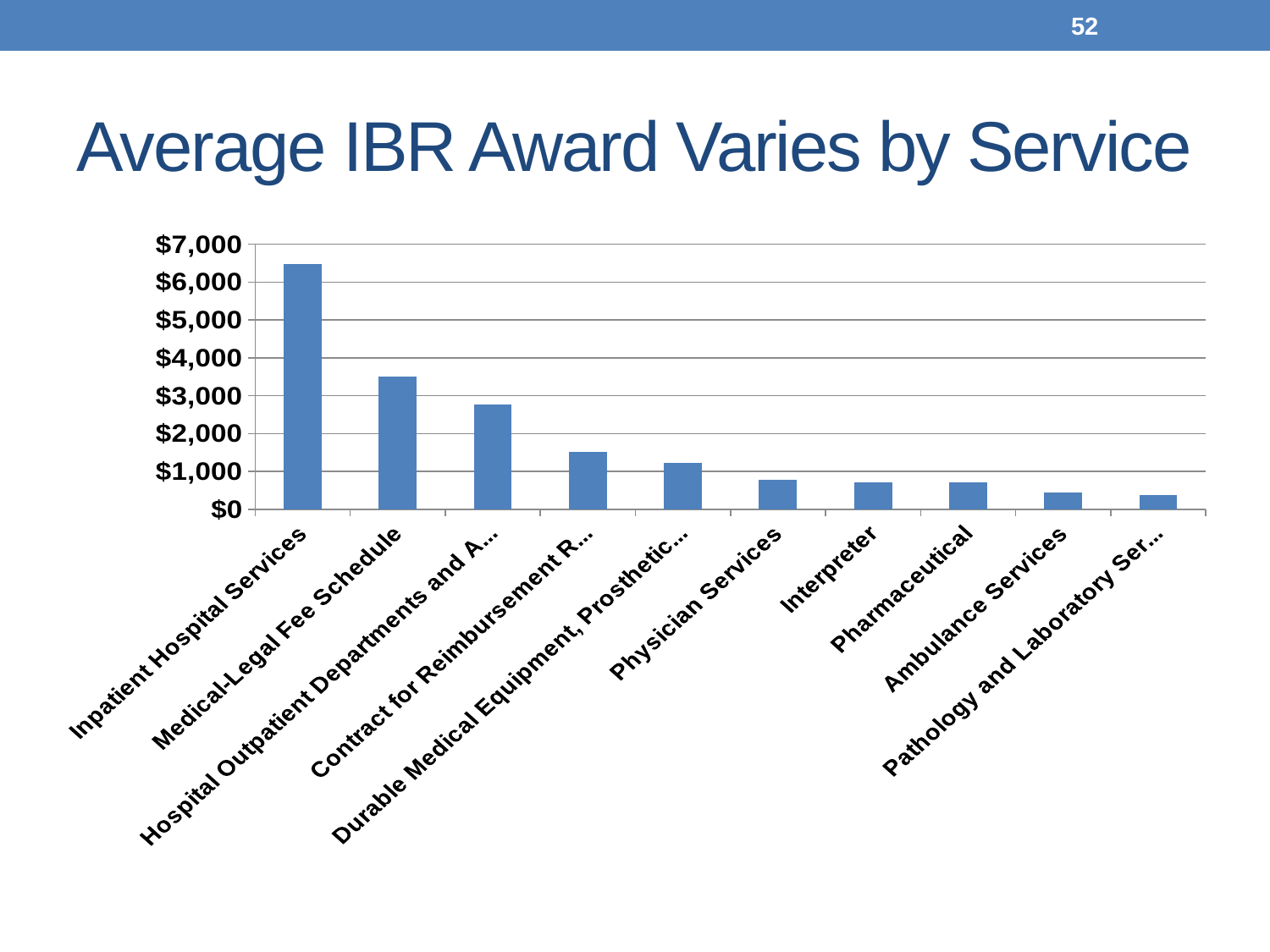
Is the value for Contract for Reimbursement R... greater or less than $1,000? greater Is the value for Durable Medical Equipment, Prosthetic... greater or less than $2,000? less What is the title of the chart? Average IBR Award Varies by Service How many service categories are plotted in the chart? 10 Do the bar values rise or fall moving from left to right across the chart? fall Is the value for Physician Services greater or less than $1,000? less Which is larger, the value for Medical-Legal Fee Schedule or the value for Physician Services? Medical-Legal Fee Schedule What kind of chart is shown on the slide? bar chart Which is larger, the value for Physician Services or the value for Ambulance Services? Physician Services Which service has the highest average IBR award? Inpatient Hospital Services